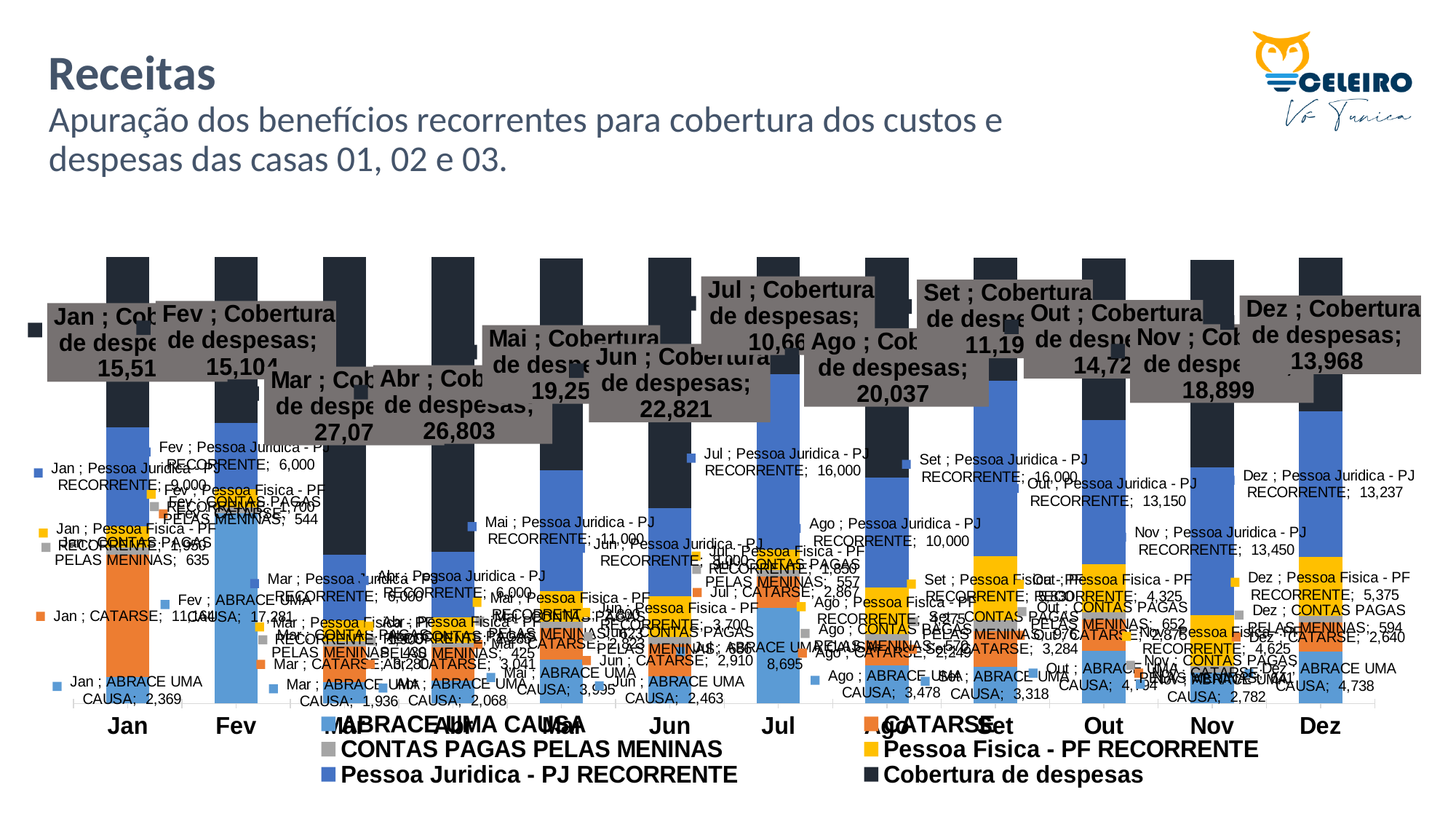
What is the difference between Pessoa Juridica - PJ RECORRENTE for Nov (13,450) and for Dez (13,237)? 213 What is the value of ABRACE UMA CAUSA for Fev? 17,281 How many series does the legend list? 6 Which is larger, Pessoa Juridica - PJ RECORRENTE for Jul or for Ago? Jul What is the value of Pessoa Fisica - PF RECORRENTE for Dez? 5,375 What kind of chart is shown on the slide? stacked bar chart What is the value of Cobertura de despesas for Nov? 18,899 What is the value of Pessoa Juridica - PJ RECORRENTE for Jul? 16,000 How many months are shown on the x axis? 12 What is the value of CATARSE for Jan? 11,164 What is the value of Cobertura de despesas for Ago? 20,037 Which month has the highest value for ABRACE UMA CAUSA? Fev